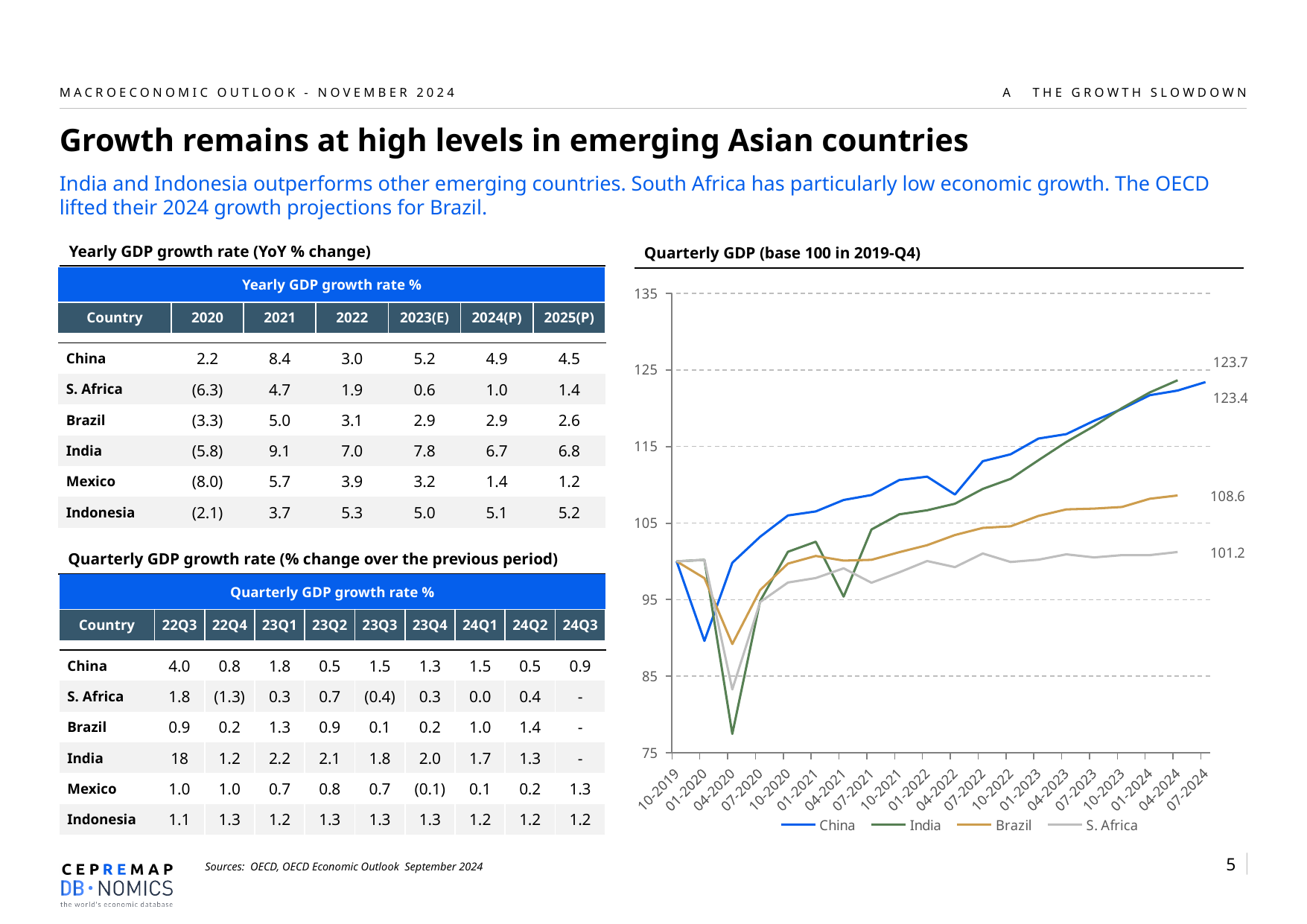
What is the title of the chart? Quarterly GDP (base 100 in 2019-Q4) Which series has the lowest value in 04-2020 in the Quarterly GDP chart? India What is the final labelled value for S. Africa in the Quarterly GDP chart? 101.2 What kind of chart is shown on the slide? line chart What is the final labelled value for Brazil in the Quarterly GDP chart? 108.6 What is the difference between the final labelled values of Brazil and S. Africa? 7.4 Is the value for China in 01-2020 greater or less than 95? less Which series are listed in the legend of the Quarterly GDP chart? China, India, Brazil, S. Africa At the end of the series, which is larger: Brazil or S. Africa? Brazil How many series does the legend of the Quarterly GDP chart list? 4 Is the value for India in 04-2020 greater or less than 85? less